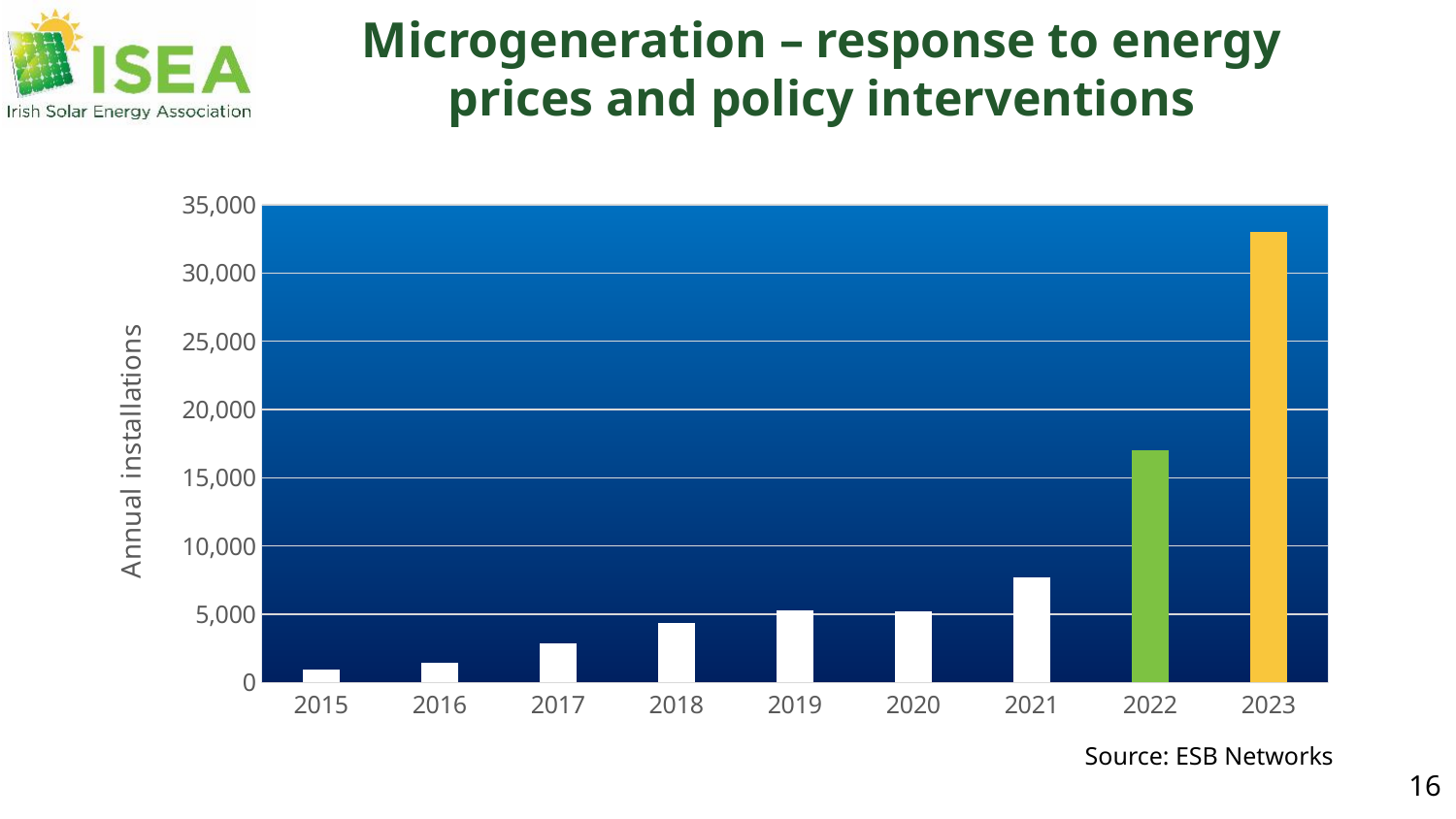
Is the value for 2023 greater or less than 30,000? greater Is the value for 2018 greater or less than 5,000? less Is the value for 2022 greater or less than 20,000? less What kind of chart is shown on the slide? Bar chart Which year has more annual installations, 2021 or 2022? 2022 How many years are shown on the x axis of the chart? 9 What is the label on the vertical axis of the chart? Annual installations Which year has the highest number of annual installations? 2023 Which year has the lowest number of annual installations? 2015 Do annual installations generally rise or fall from 2015 to 2023? Rise